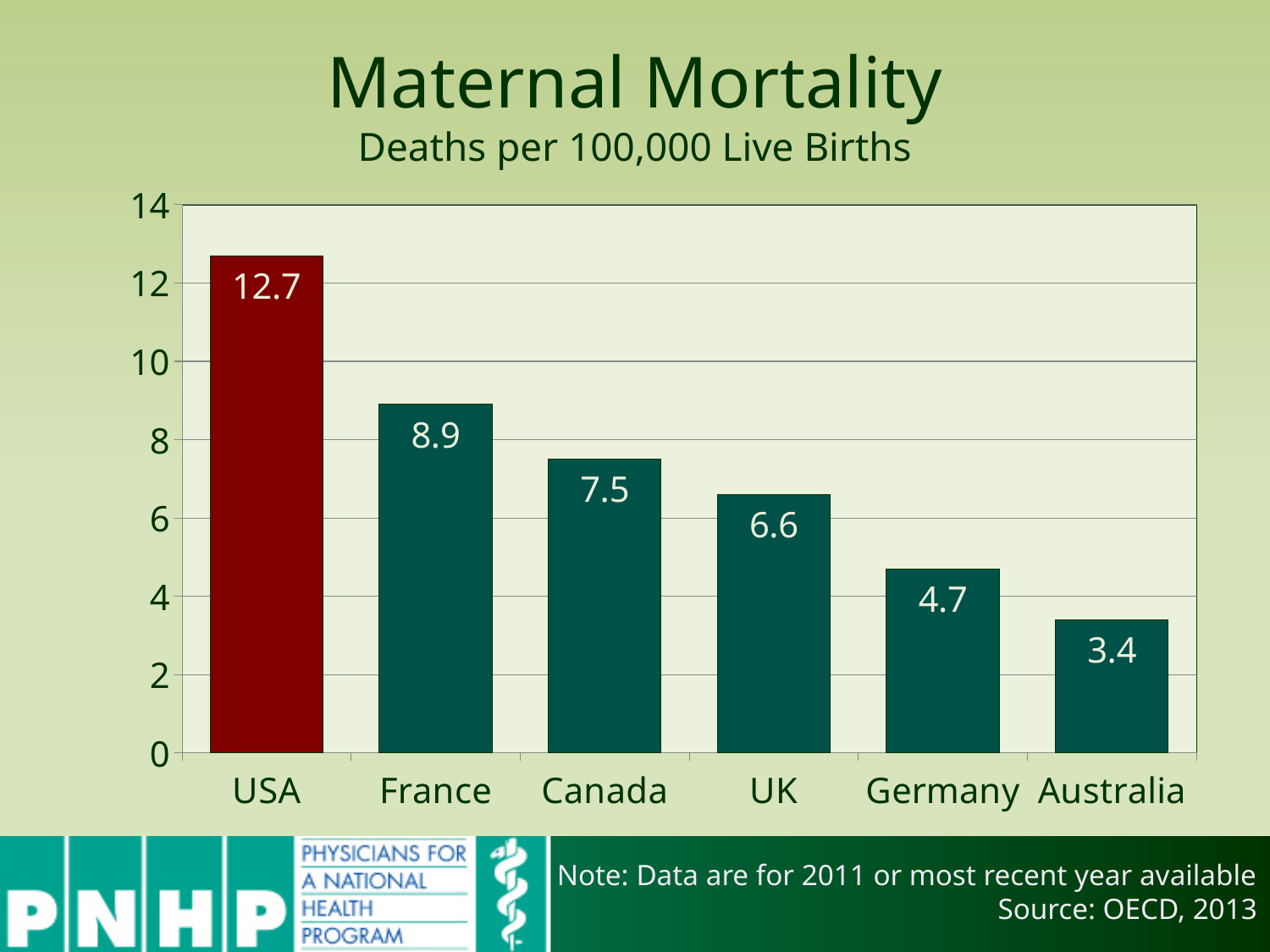
Is the value for France greater or less than 10? less What kind of chart is shown on the slide? bar chart Which country has the highest maternal mortality rate? USA Which country has the lowest maternal mortality rate? Australia What is the difference between the maternal mortality values for Canada and Australia? 4.1 What is the maternal mortality value for Germany? 4.7 What is the maternal mortality value for the USA? 12.7 What is the difference between the maternal mortality values for the USA and France? 3.8 What is the maternal mortality value for the UK? 6.6 Which has a higher maternal mortality rate, Canada or the UK? Canada Which bar is coloured differently (dark red) from the others? USA How many countries are shown in the chart? 6